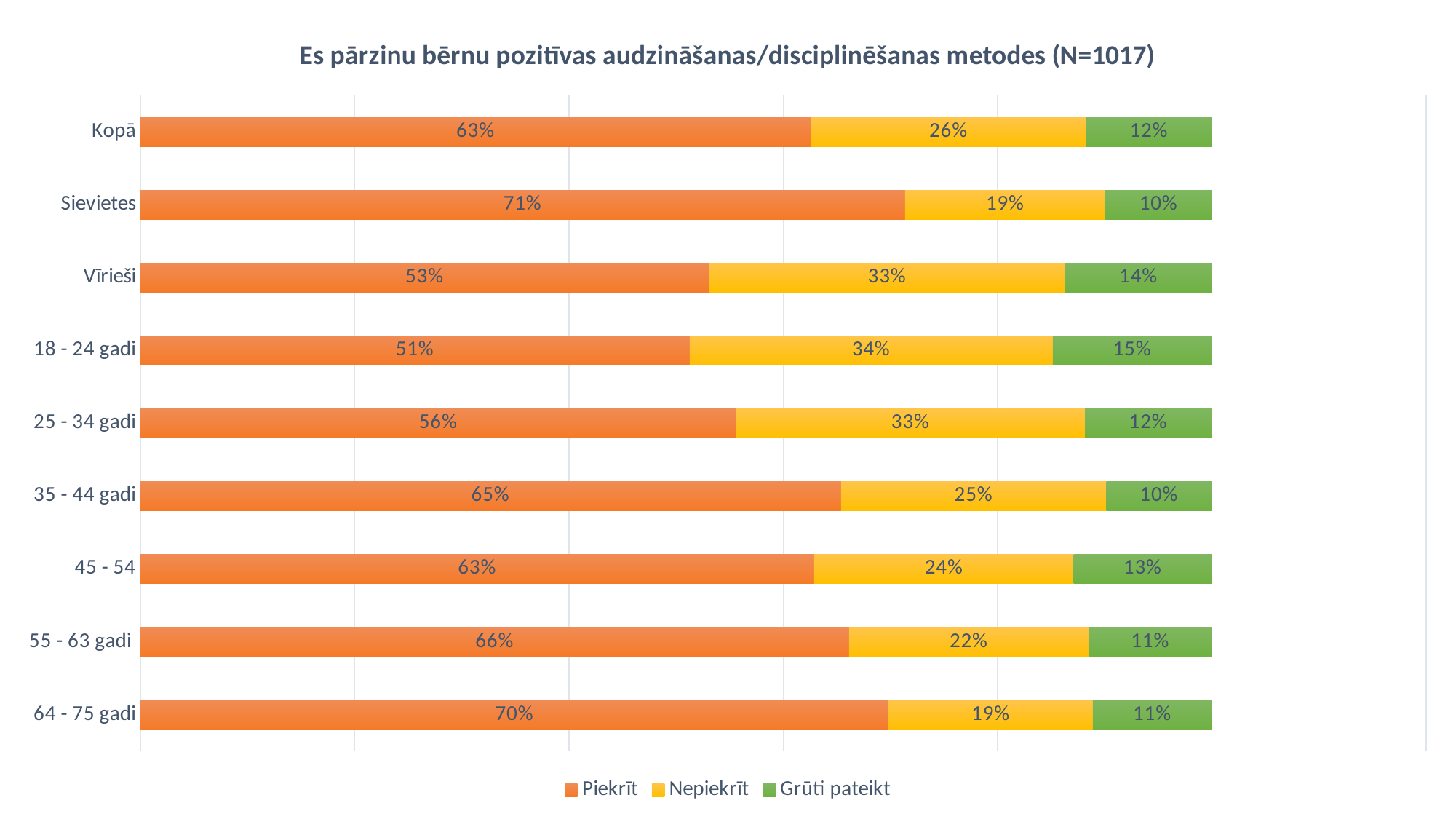
What kind of chart is shown on the slide? Stacked bar chart What is the difference between the Piekrīt values for Sievietes and Vīrieši? 18% What is the Piekrīt value for Sievietes? 71% Which category has the lowest Piekrīt value? 18 - 24 gadi What is the total of the stacked bar for Kopā? 101% Which series is shown in green? Grūti pateikt How many series does the legend list? 3 What is the Nepiekrīt value for 18 - 24 gadi? 34% Which is larger, the Nepiekrīt value for 25 - 34 gadi or for 35 - 44 gadi? 25 - 34 gadi What is the Grūti pateikt value for Vīrieši? 14% How many categories are shown on the chart? 9 Which category has the highest Piekrīt value? Sievietes